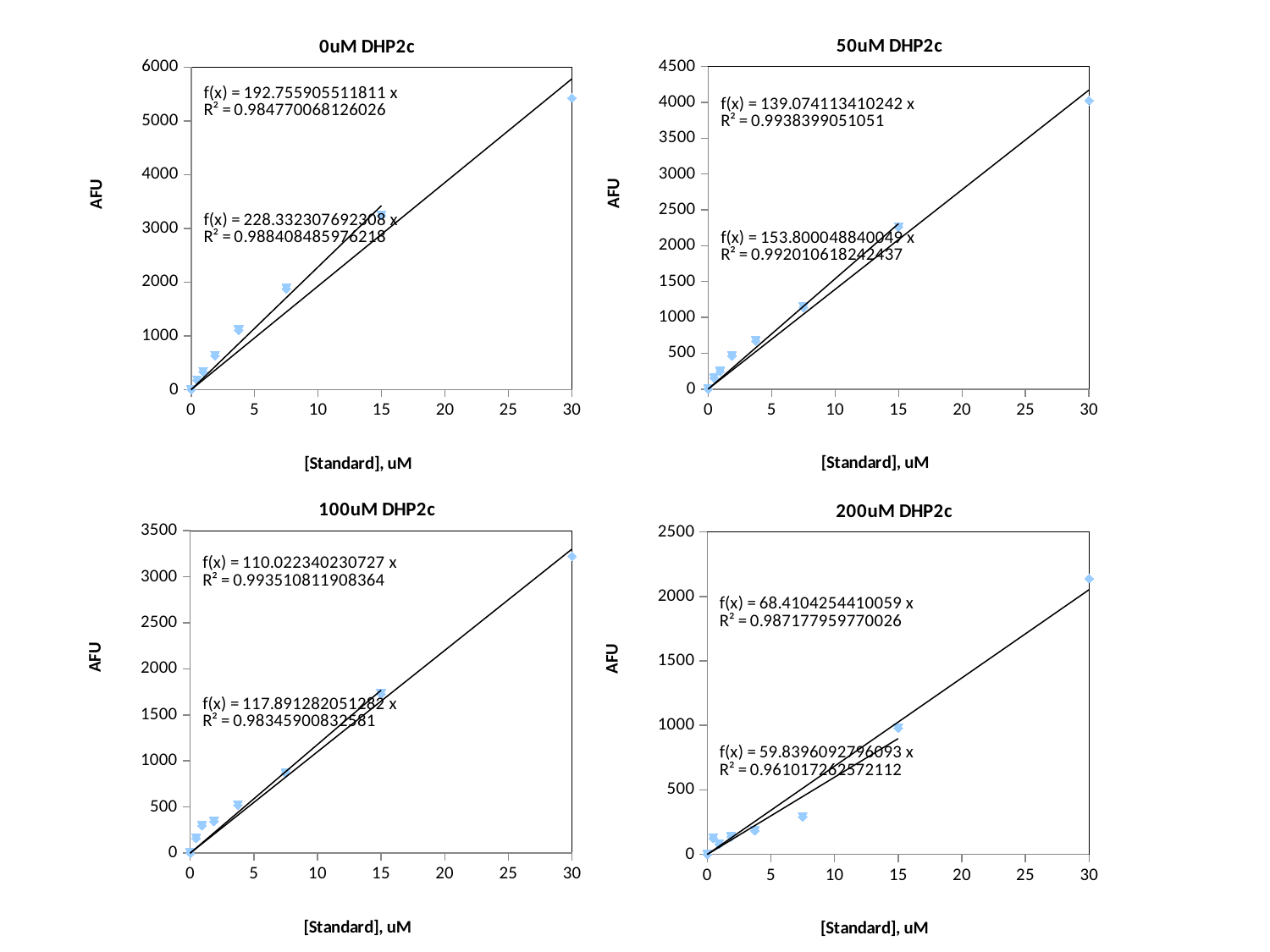
In the 0uM DHP2c chart, is the AFU value at 30 uM greater or less than 5000? greater In the 200uM DHP2c chart, is the AFU value at 7.5 uM greater or less than 500? less In the 50uM DHP2c chart, what is the R² value printed for the fit with slope 139.074113410242? 0.9938399051051 Which chart has the higher AFU value at 30 uM, the 0uM DHP2c chart or the 200uM DHP2c chart? 0uM DHP2c In the 0uM DHP2c chart, what is the R² value printed for the fit with slope 192.755905511811? 0.984770068126026 What is the x-axis label of the 50uM DHP2c chart? [Standard], uM How many charts are shown on the slide? 4 What is the y-axis label of the 100uM DHP2c chart? AFU In the 100uM DHP2c chart, do the AFU values rise or fall as the standard concentration increases? rise In the 200uM DHP2c chart, what is the slope printed in the upper equation f(x)? 68.4104254410059 What kind of chart is the top-left chart titled 0uM DHP2c? scatter chart In the 200uM DHP2c chart, is the AFU value at 30 uM greater or less than 2000? greater